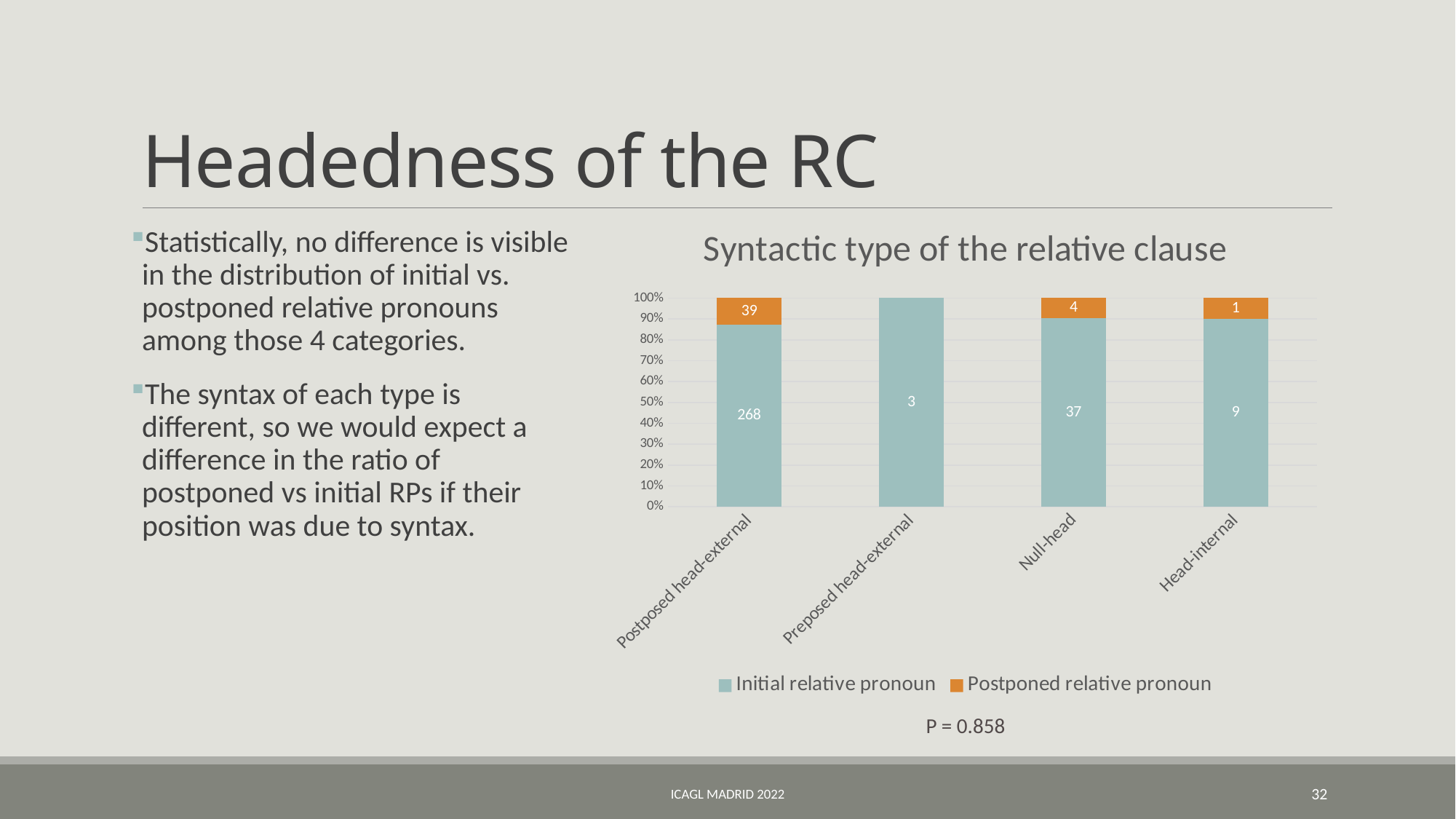
Is the Initial relative pronoun share of the Postposed head-external bar greater or less than 80%? greater What is the value for Initial relative pronoun in the Head-internal category? 9 What is the difference between the Initial relative pronoun values for Null-head and Head-internal? 28 How many categories are shown on the x axis? 4 How many series does the legend list? 2 Which is larger: the Postponed relative pronoun value for Postposed head-external or for Null-head? Postposed head-external Which category has the lowest value for Initial relative pronoun? Preposed head-external What is the title of the chart? Syntactic type of the relative clause What is the total of the stacked bar for Null-head? 41 What is the value for Postponed relative pronoun in the Null-head category? 4 Which category has the highest value for Initial relative pronoun? Postposed head-external What is the value for Initial relative pronoun in the Postposed head-external category? 268